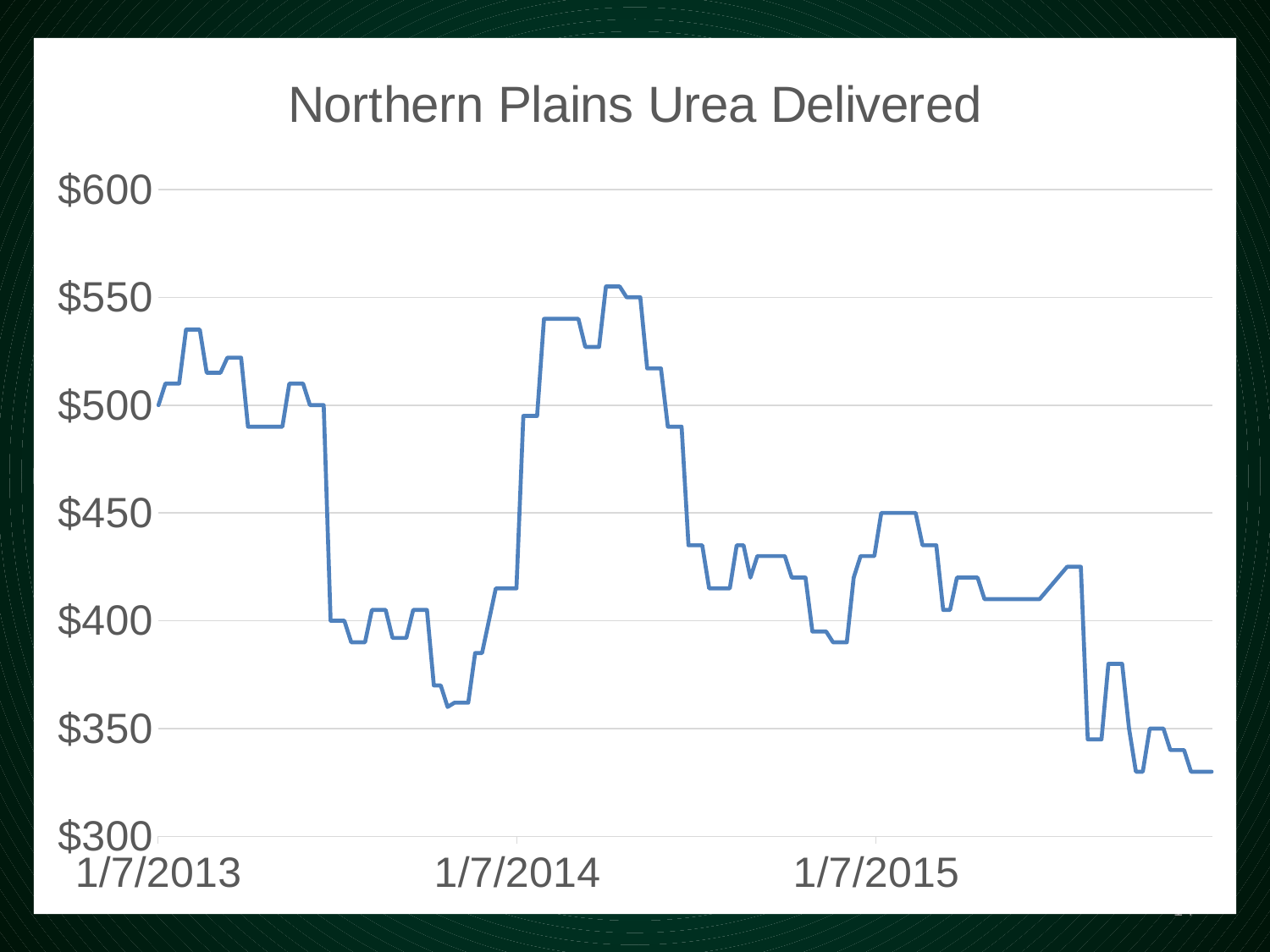
What is the title of the chart? Northern Plains Urea Delivered How many date labels are shown on the x axis? 3 What kind of chart is shown on the slide? line chart Is the value at 1/7/2014 greater or less than $450? less Is the lowest value on the chart greater or less than $350? less Overall, does the value rise or fall from the start of the series to the end? fall Is the value at the end of the series (late 2015) greater or less than $350? less